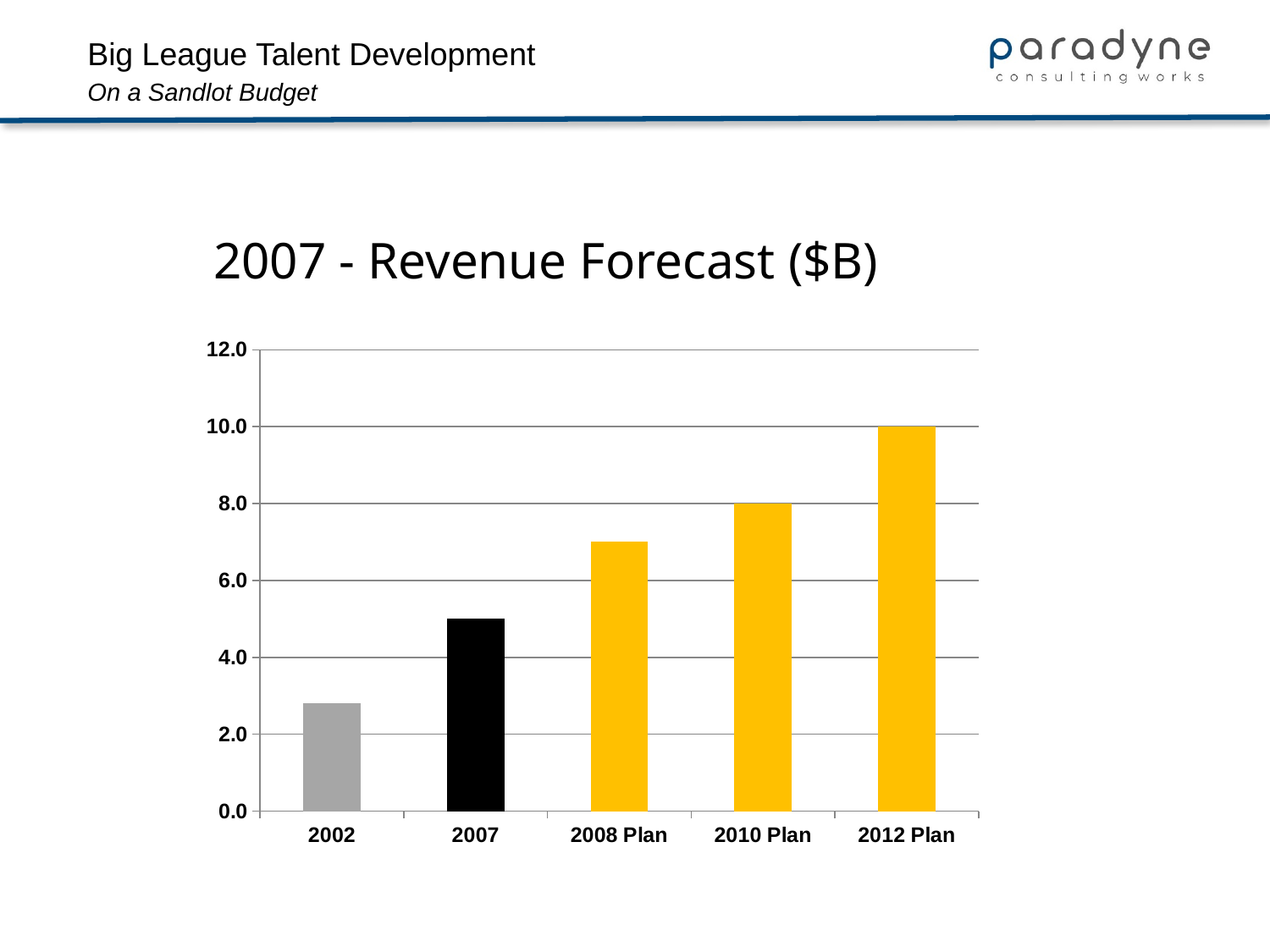
What is the difference between the values for 2012 Plan and 2010 Plan? 2.0 Is the value for 2002 greater or less than 4.0? less What is the value for 2010 Plan? 8.0 Which category has the lowest value? 2002 What is the title of the chart? 2007 - Revenue Forecast ($B) Which category has the highest value? 2012 Plan What type of chart is shown on the slide? bar chart How many categories are shown on the x axis of the chart? 5 What is the value for 2012 Plan? 10.0 Do the values rise or fall from left to right along the x axis? rise Which is larger, the value for 2007 or the value for 2008 Plan? 2008 Plan Is the value for 2008 Plan greater or less than 6.0? greater